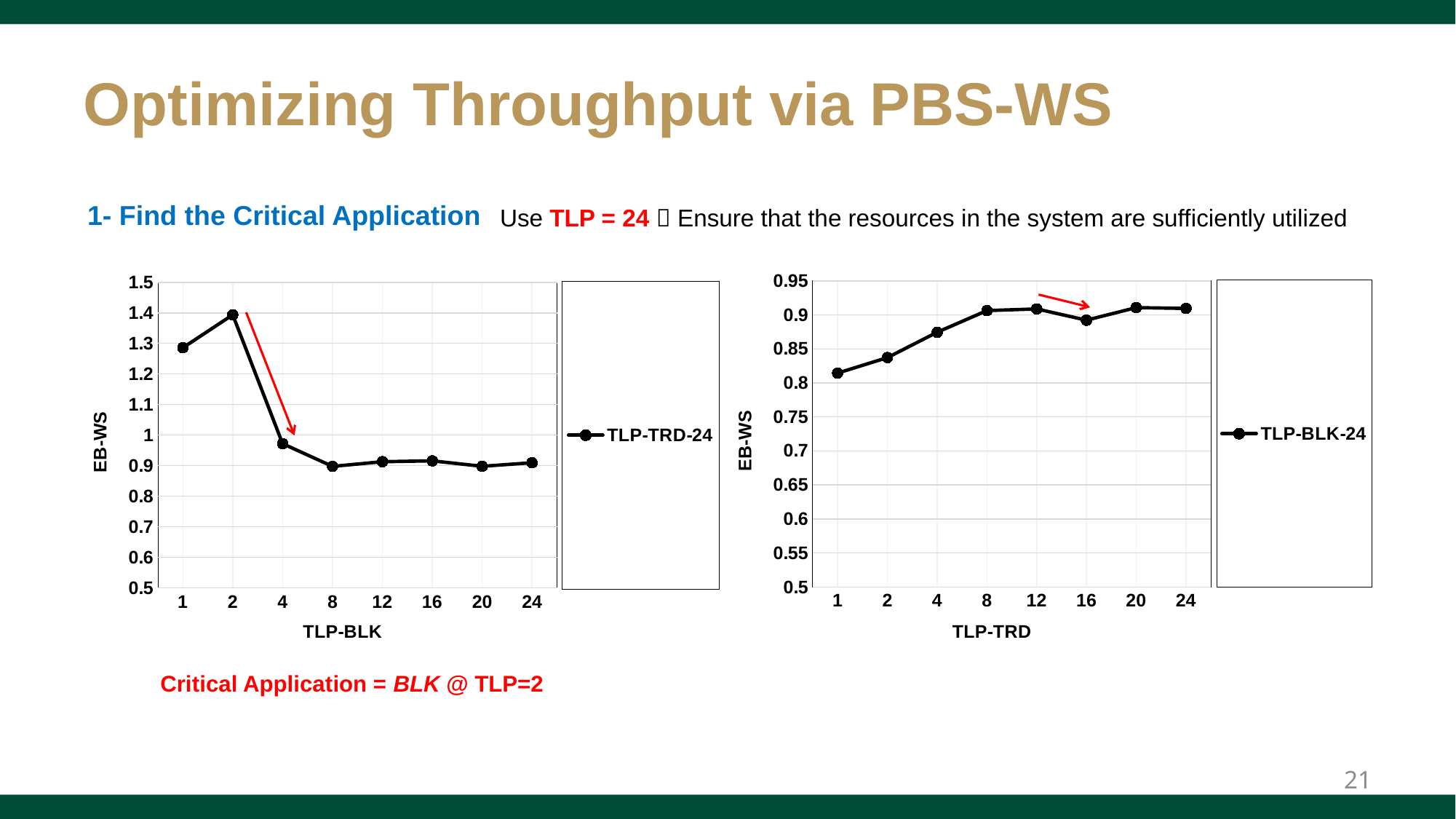
In the left chart (x-axis TLP-BLK), which has the higher EB-WS value: TLP-BLK = 1 or TLP-BLK = 4? TLP-BLK = 1 In the right chart (x-axis TLP-TRD), at which TLP-TRD value is EB-WS lowest? 1 In the right chart (x-axis TLP-TRD), does EB-WS generally rise or fall from TLP-TRD = 1 to TLP-TRD = 8? rise In the left chart (x-axis TLP-BLK), at which TLP-BLK value is EB-WS highest? 2 What is the legend entry of the series in the left chart (x-axis TLP-BLK)? TLP-TRD-24 In the right chart (x-axis TLP-TRD), how many series does the legend list? 1 In the left chart (x-axis TLP-BLK), is the EB-WS value at TLP-BLK = 2 greater or less than 1.3? greater In the right chart (x-axis TLP-TRD), is the EB-WS value at TLP-TRD = 1 greater or less than 0.85? less What kind of chart is the left chart with x-axis TLP-BLK? line chart What kind of chart is the right chart with x-axis TLP-TRD? line chart In the left chart (x-axis TLP-BLK), how many data points are plotted? 8 In the left chart (x-axis TLP-BLK), is the EB-WS value at TLP-BLK = 8 greater or less than 1? less